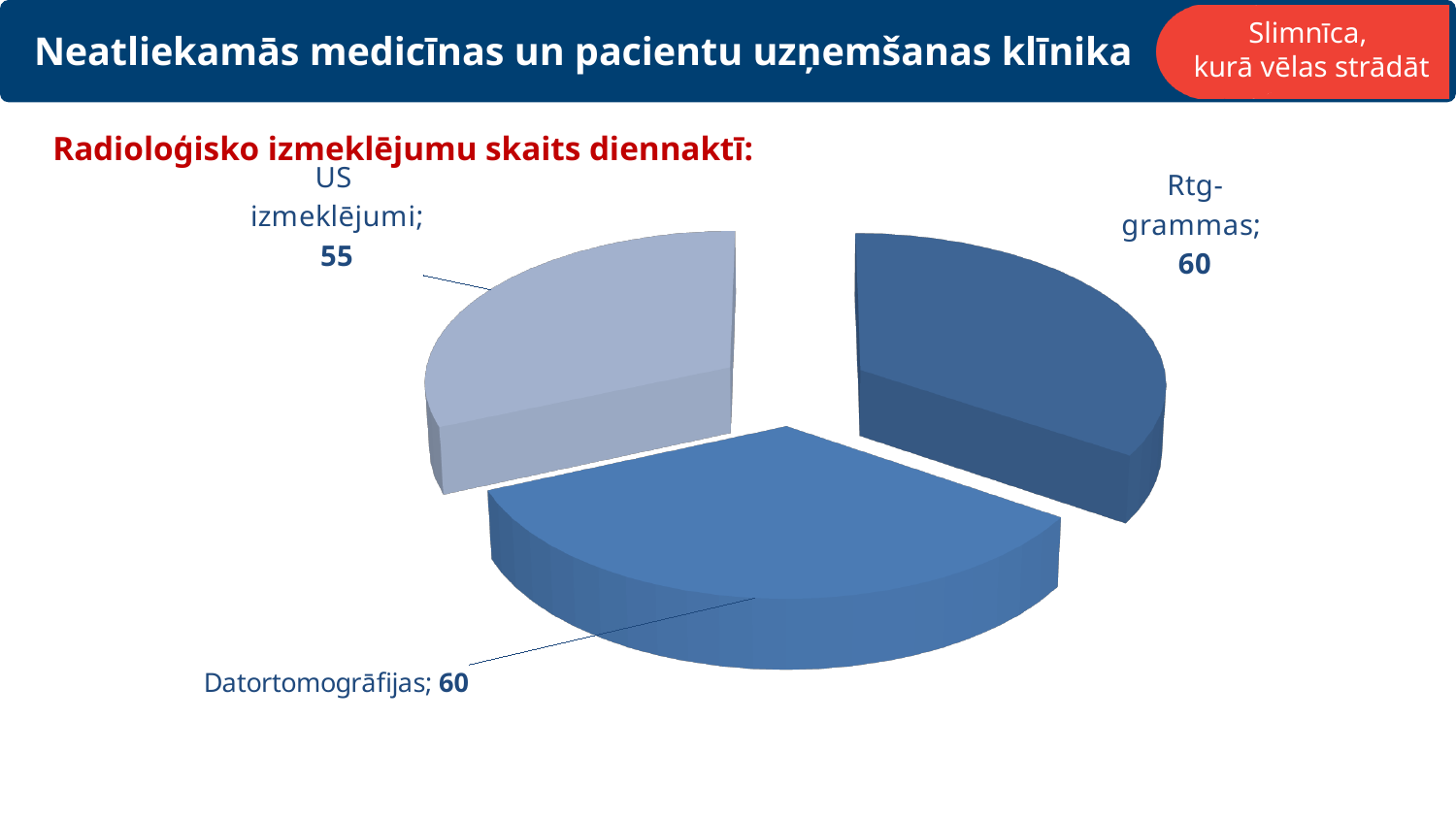
What type of chart is shown on the slide? pie chart Which category has the lowest value? US izmeklējumi Which is larger, the value for Rtg-grammas or the value for US izmeklējumi? Rtg-grammas What is the difference between the value for Datortomogrāfijas and the value for US izmeklējumi? 5 What is the value for Datortomogrāfijas? 60 What is the title of the chart? Radioloģisko izmeklējumu skaits diennaktī: What is the total of all slices in the pie chart? 175 What is the value for US izmeklējumi? 55 What share of the pie does Rtg-grammas represent? 34.3% What share of the pie does US izmeklējumi represent? 31.4% What is the value for Rtg-grammas? 60 How many slices does the pie chart have? 3